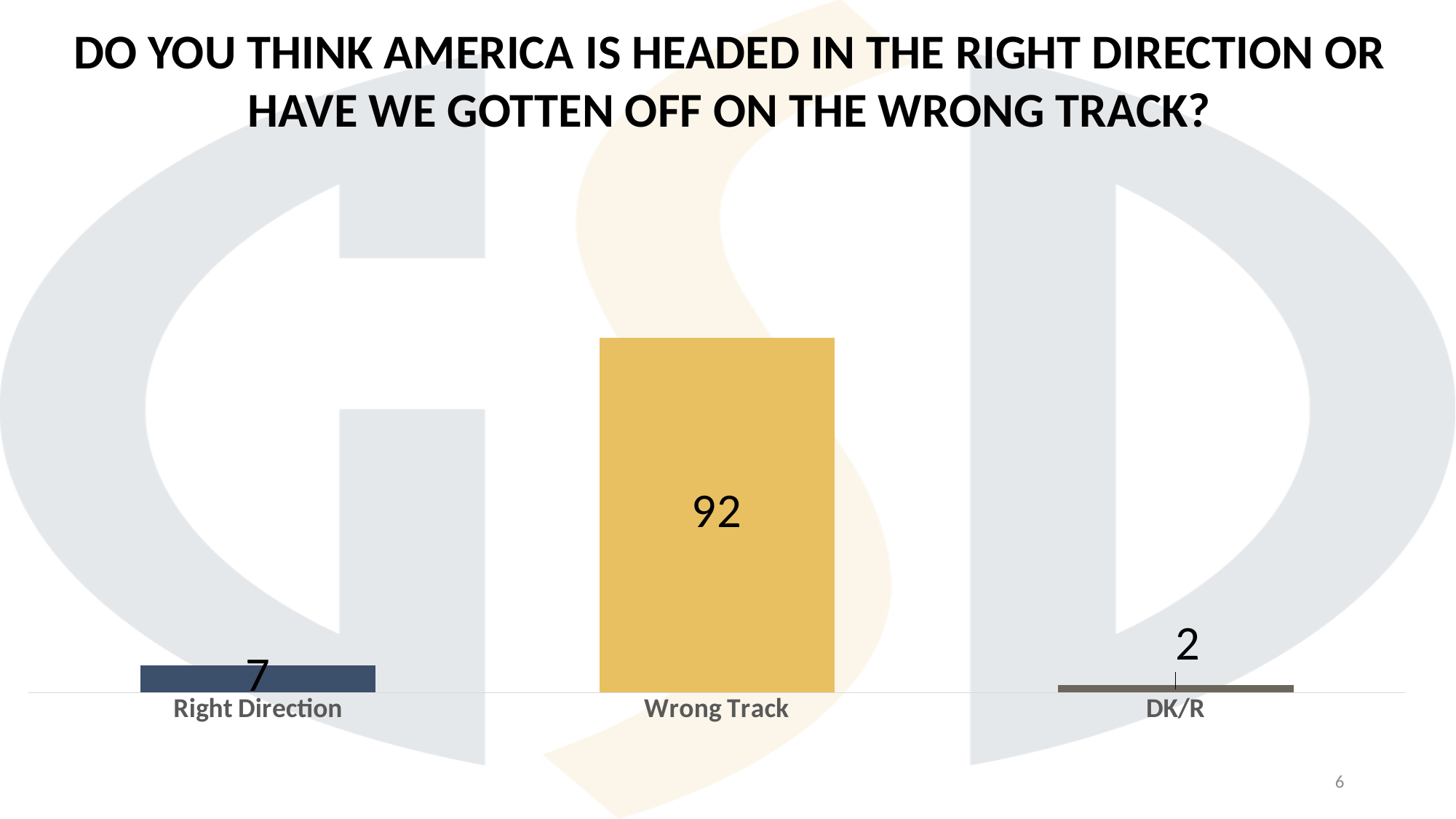
What is the total of the three values shown in the chart? 101 What is the difference between the values for Right Direction and DK/R? 5 What is the value for Wrong Track? 92 How many categories are shown in the chart? 3 What is the value for Right Direction? 7 What is the value for DK/R? 2 What colour is the Wrong Track bar? Yellow What is the difference between the values for Wrong Track and Right Direction? 85 Which category has the lowest value? DK/R What kind of chart is shown on the slide? Bar chart Which is larger, the value for Right Direction or the value for DK/R? Right Direction Which category has the highest value? Wrong Track